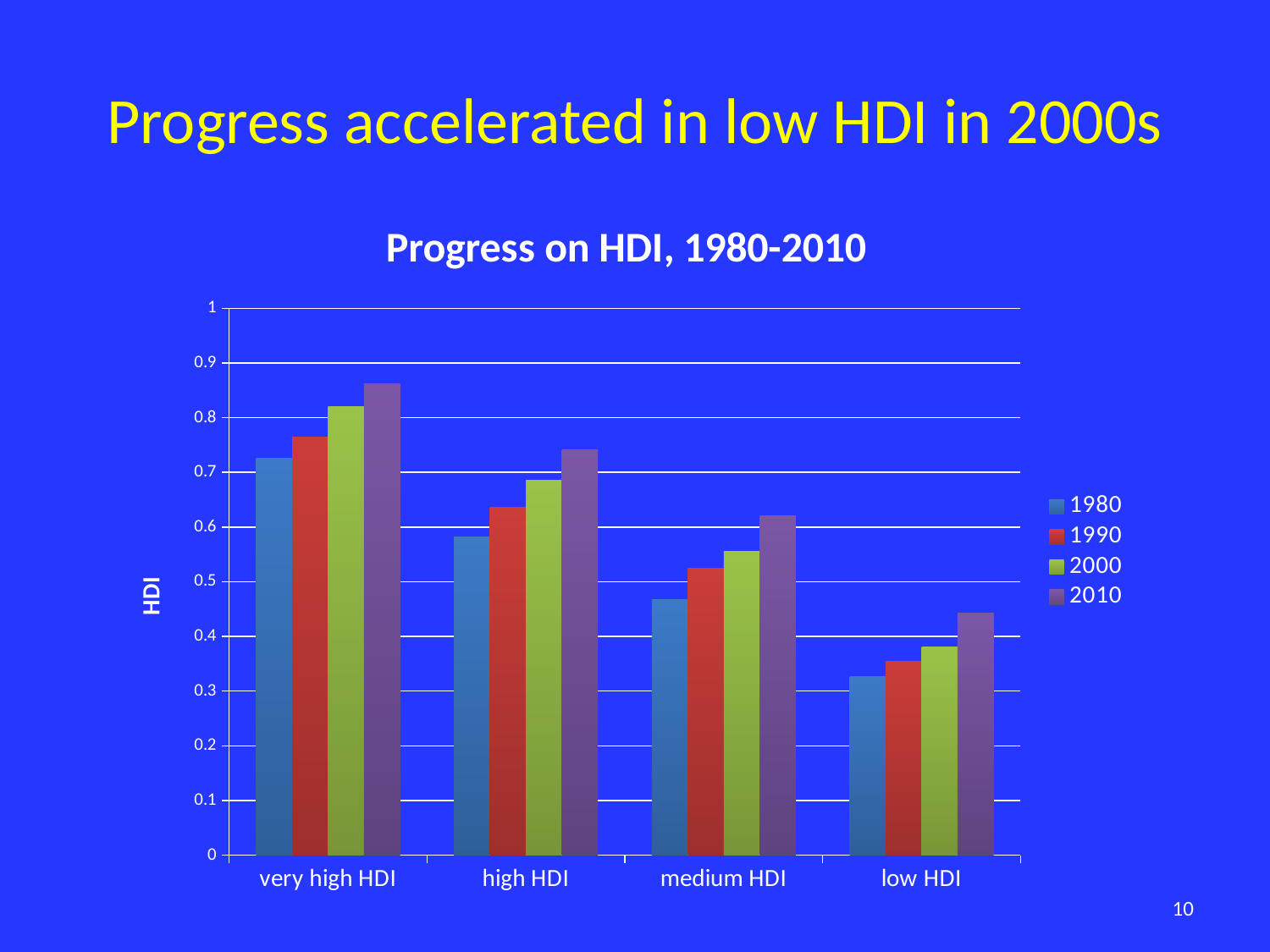
Within the low HDI category, do the values rise or fall from 1980 to 2010? rise Is the 1980 value for medium HDI greater or less than 0.5? less How many series does the legend list? 4 What is the title of the chart? Progress on HDI, 1980-2010 How many categories are shown on the x axis? 4 Which category has the highest HDI value in 2010? very high HDI Is the 2010 value for very high HDI greater or less than 0.8? greater Is the 1980 value for high HDI greater or less than 0.5? greater What kind of chart is shown on the slide? bar chart Which is larger: the 2010 value for medium HDI or the 1980 value for high HDI? 2010 value for medium HDI Which category has the lowest HDI value in 1980? low HDI